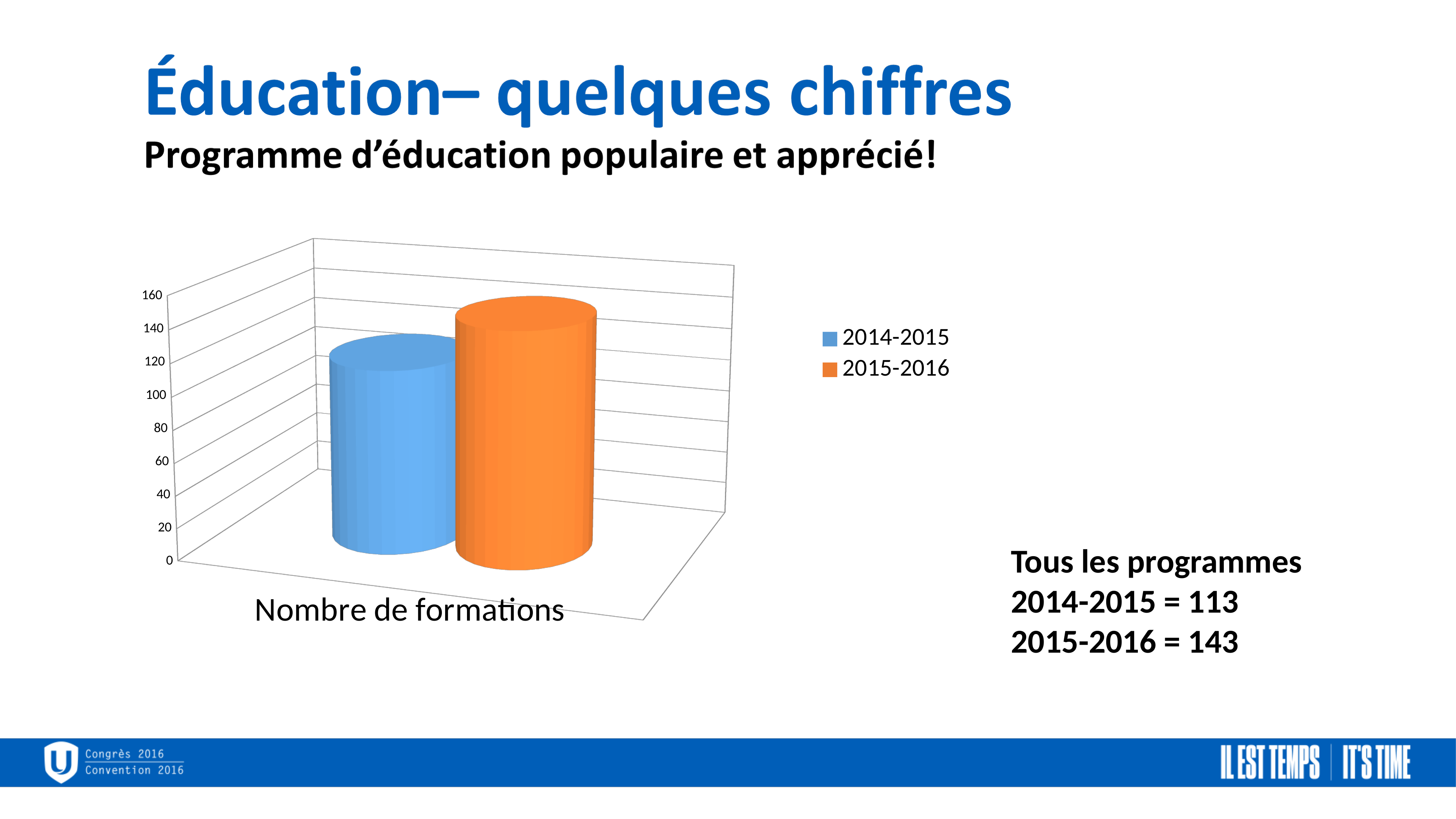
How many categories are plotted on the x axis of the chart? 1 Which series has the taller bar, 2014-2015 or 2015-2016? 2015-2016 Is the value for 2015-2016 greater or less than 160? less Which series has the highest value in the chart? 2015-2016 What is the category label shown under the bars on the x axis? Nombre de formations Which colour represents the 2015-2016 series in the legend? orange Is the value for 2014-2015 greater or less than 140? less Which series has the lowest value in the chart? 2014-2015 Is the value for 2014-2015 greater or less than 100? greater What kind of chart is shown on the slide? bar chart How many series does the chart legend list? 2